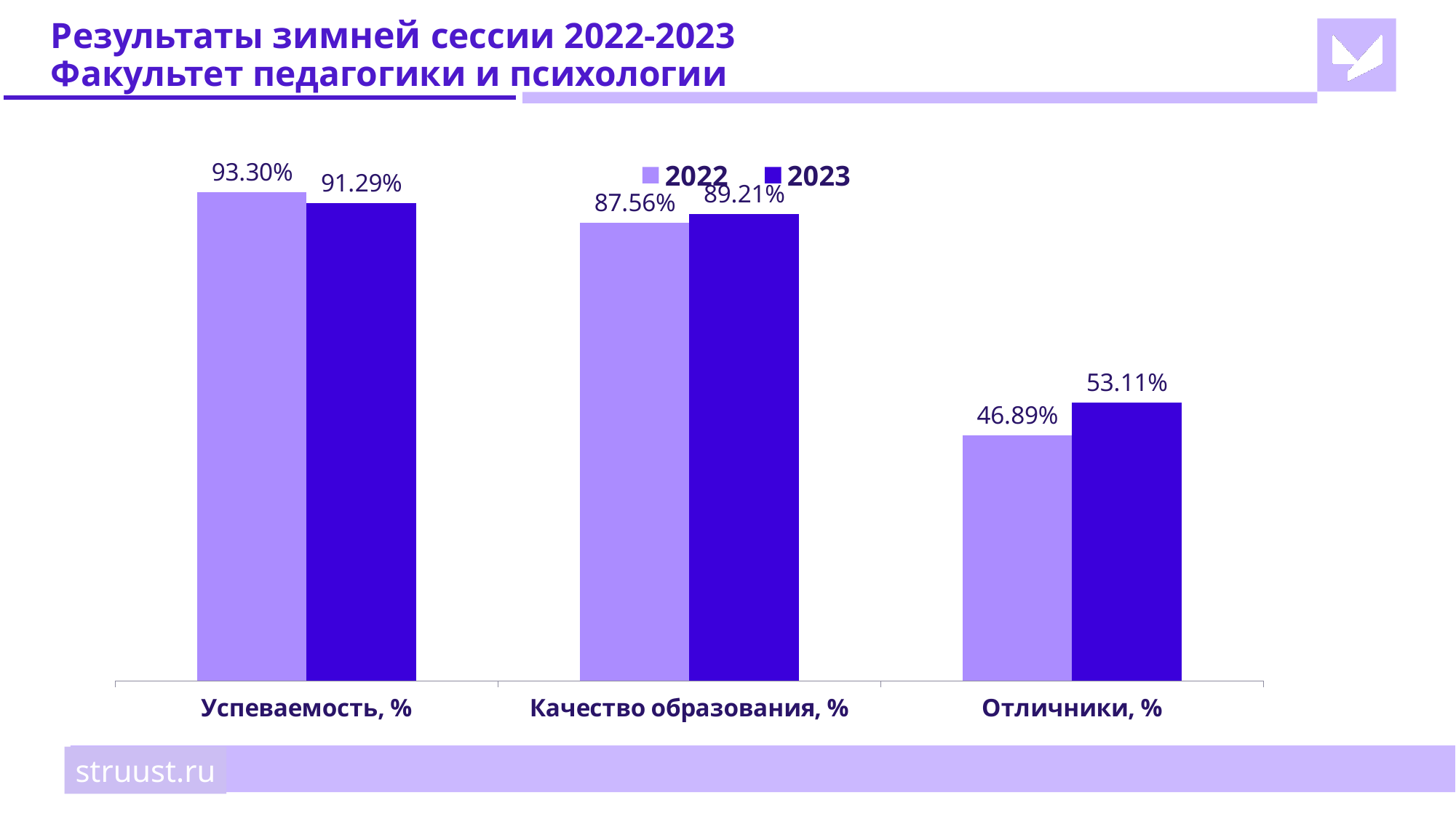
Which category has the lowest 2022 value? Отличники, % How many series does the legend list? 2 Which category has the highest 2023 value? Успеваемость, % What is the 2023 value for Качество образования, %? 89.21% What is the 2022 value for Отличники, %? 46.89% What is the 2023 value for Отличники, %? 53.11% What is the 2022 value for Успеваемость, %? 93.30% What is the difference between the 2022 and 2023 values for Успеваемость, %? 2.01% For Качество образования, %, which year has the larger value, 2022 or 2023? 2023 What is the difference between the 2023 and 2022 values for Отличники, %? 6.22% What kind of chart is shown on the slide? Bar chart How many categories are shown on the x axis? 3